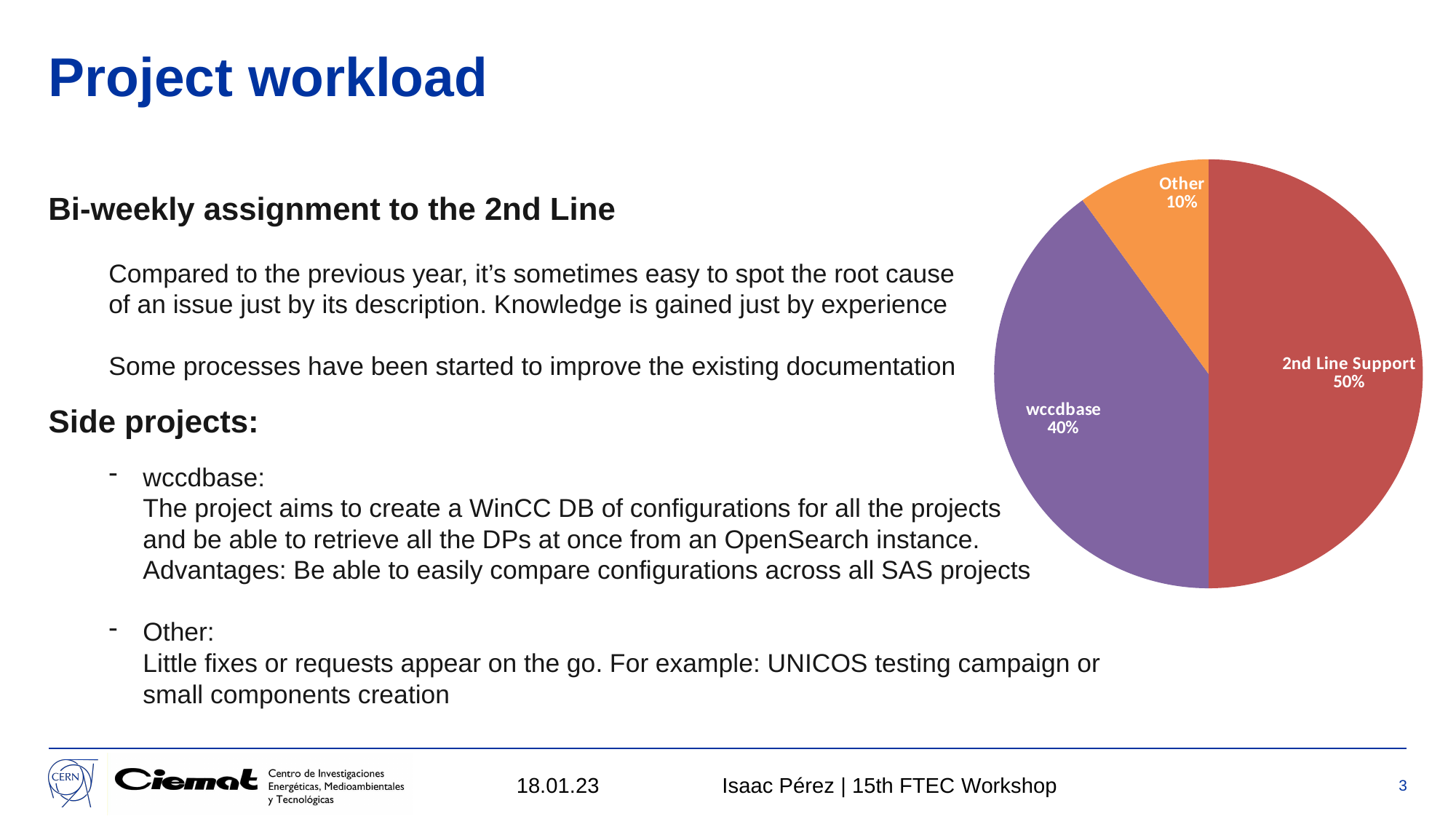
What share of the pie does 2nd Line Support take? 50% What is the difference in percentage points between wccdbase and Other? 30% What colour is the Other slice? orange What share of the pie does Other take? 10% What colour is the 2nd Line Support slice? red Which is larger, the wccdbase slice or the Other slice? wccdbase How many slices does the pie chart have? 3 What share of the pie does wccdbase take? 40% Which slice of the pie is the smallest? Other What is the difference in percentage points between 2nd Line Support and wccdbase? 10% What kind of chart is shown on the slide? pie chart Which slice of the pie is the largest? 2nd Line Support